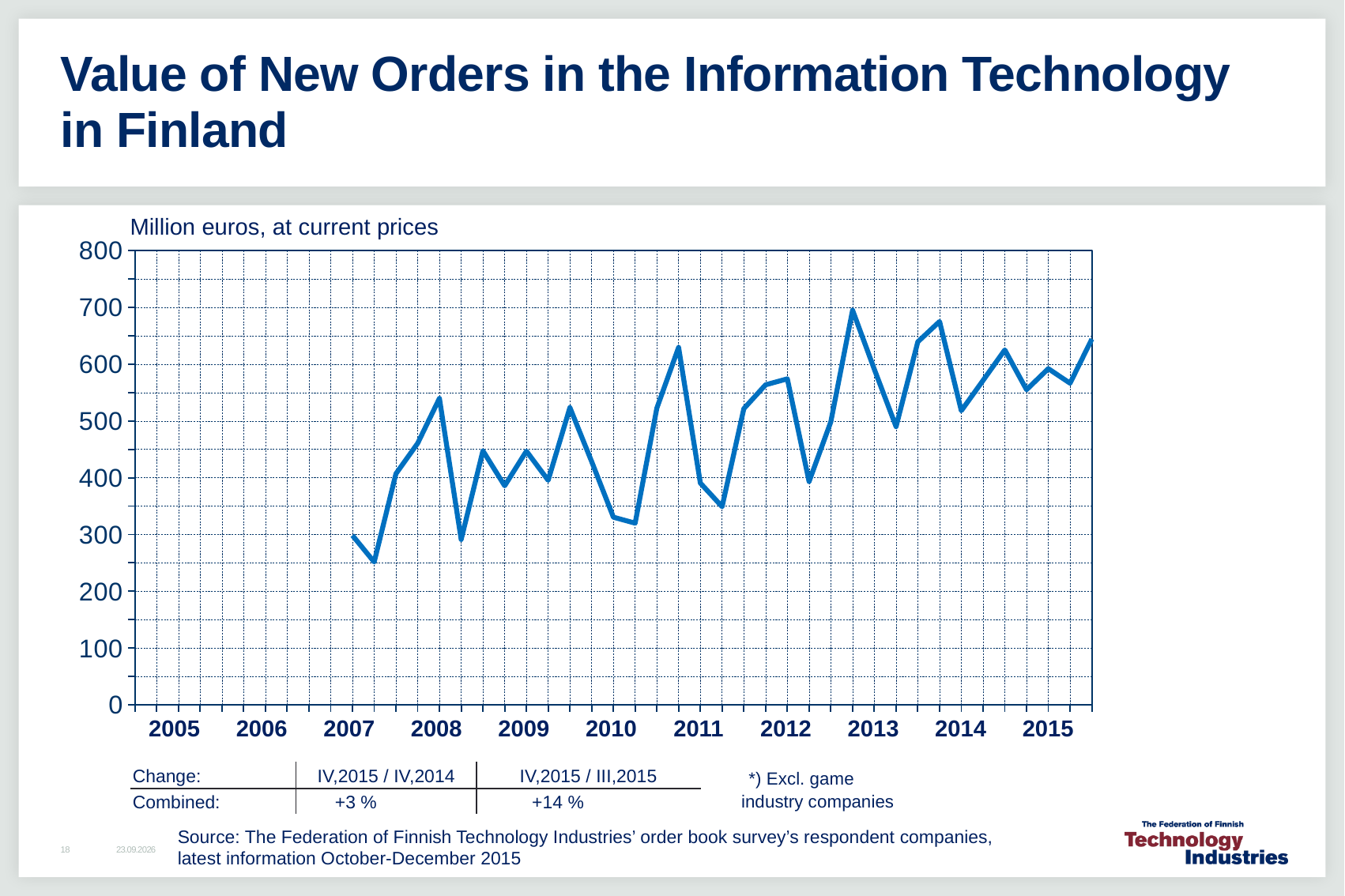
In which year does the line reach its lowest point? 2007 Overall, do the values rise or fall from 2007 to 2015? rise Which is larger, the peak value in 2008 or the peak value in 2012? 2012 In which year does the line reach its highest point? 2013 How many years are labelled on the x axis? 11 What is the combined change for IV,2015 / IV,2014 shown below the chart? +3 % What kind of chart is shown on the slide? line chart What unit is the value of new orders measured in, according to the axis label? Million euros, at current prices Is the value at the last point of 2015 greater or less than 600? greater Is the lowest value in 2007 greater or less than 300? less